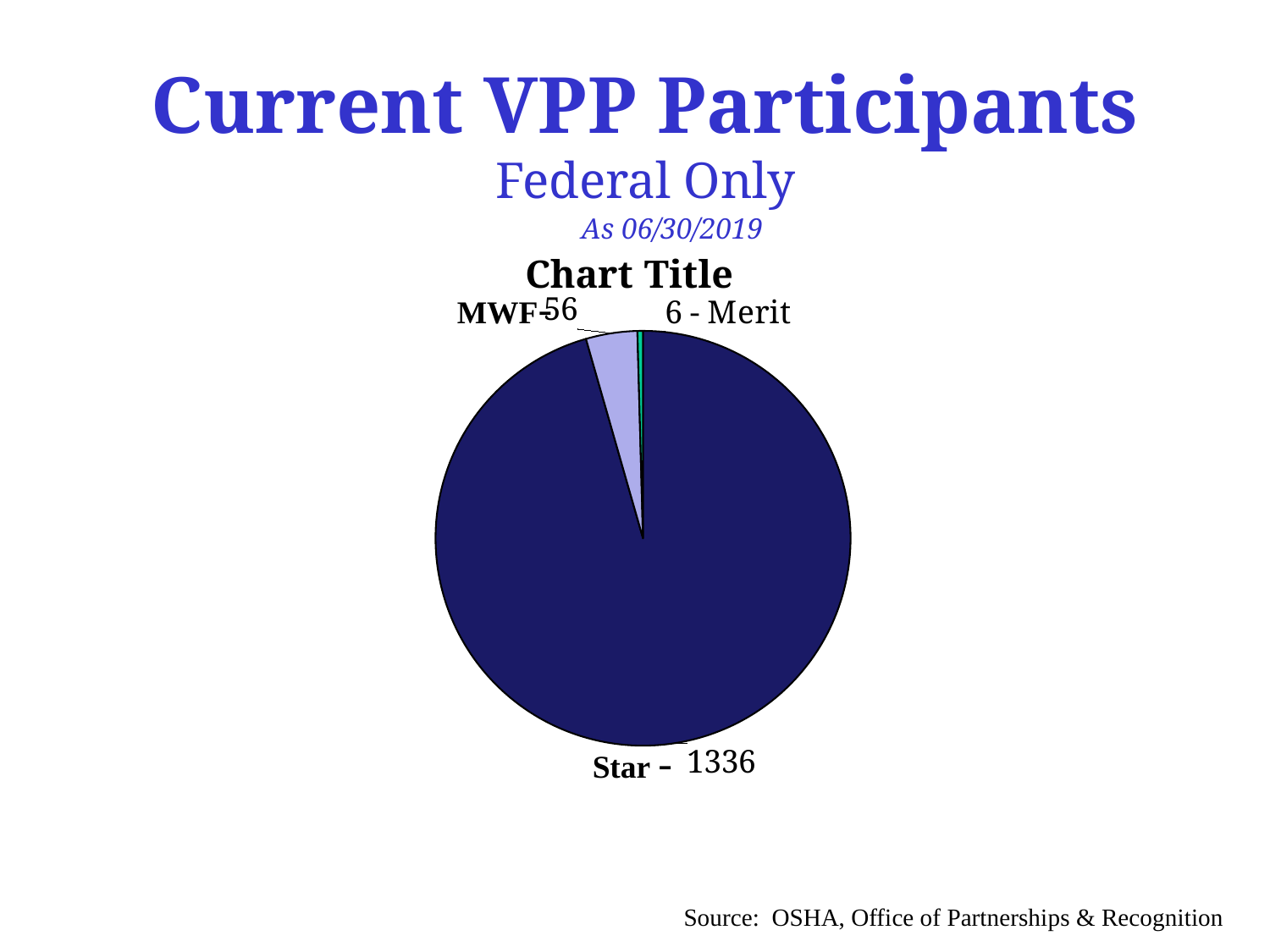
What is the value for MWF in the pie chart? 56 Which is larger, the value for MWF or the value for Merit? MWF What is the value for Merit in the pie chart? 6 What date is the pie chart data current as of, according to the slide? 06/30/2019 Which category has the smallest slice of the pie chart? Merit What is the value for Star in the pie chart? 1336 Which category has the largest slice of the pie chart? Star How many slices does the pie chart have? 3 What is the total of all three slices in the pie chart? 1398 What is the difference between the Star value and the MWF value? 1280 What type of chart is shown on the slide? pie chart What is the difference between the MWF value and the Merit value? 50